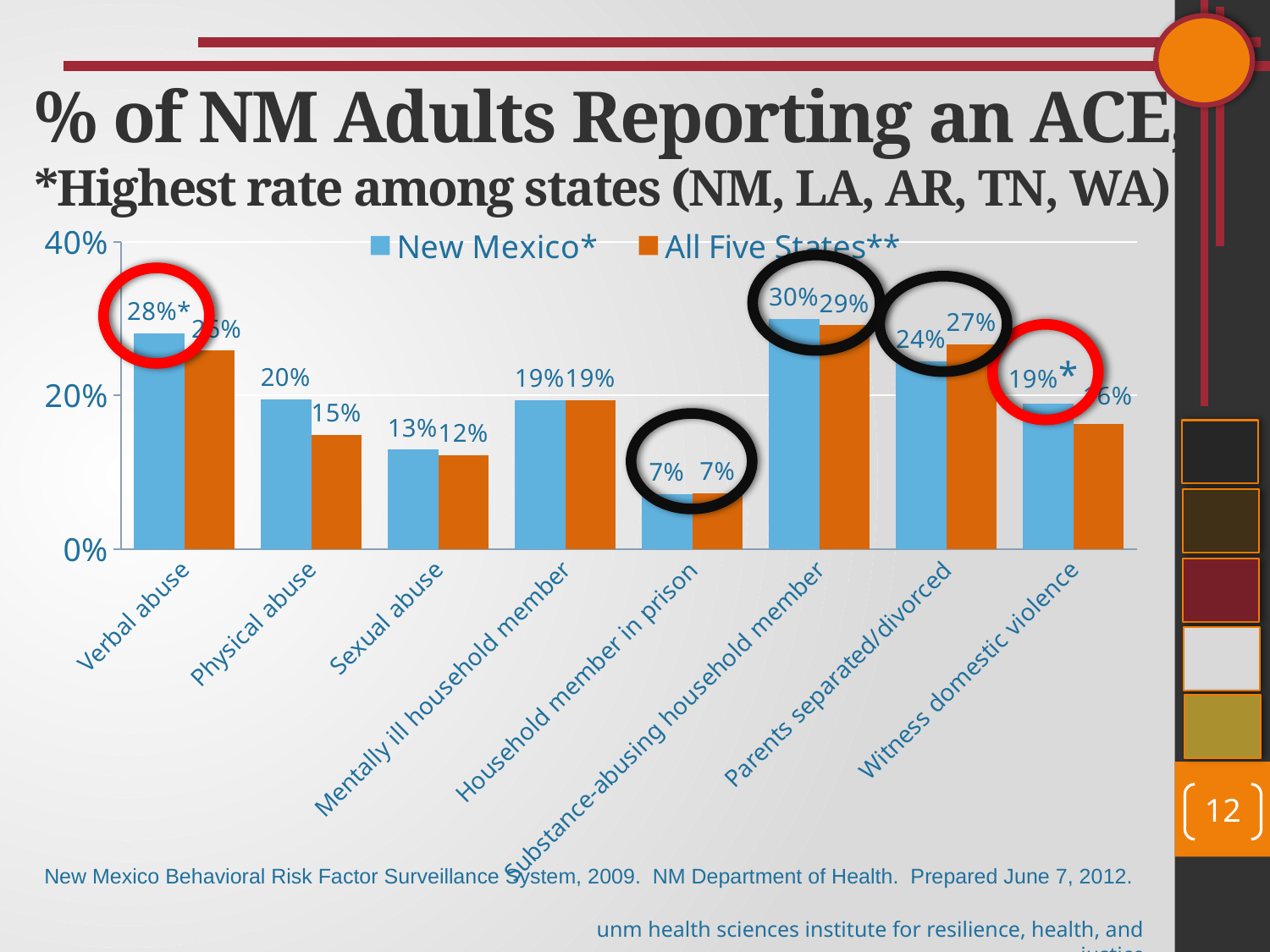
What is the value for All Five States for Parents separated/divorced? 27% Which category has the highest value for New Mexico? Substance-abusing household member What is the value for All Five States for Physical abuse? 15% What is the value for New Mexico for Physical abuse? 20% What kind of chart is shown on the slide? Bar chart For Parents separated/divorced, which series has the larger value, New Mexico or All Five States? All Five States How many series does the legend list? 2 What is the difference between the New Mexico and All Five States values for Physical abuse? 5 percentage points What is the value for New Mexico for Substance-abusing household member? 30% How many categories are shown on the x axis? 8 Is the All Five States value for Verbal abuse greater or less than 20%? greater Which category has the lowest value for New Mexico? Household member in prison